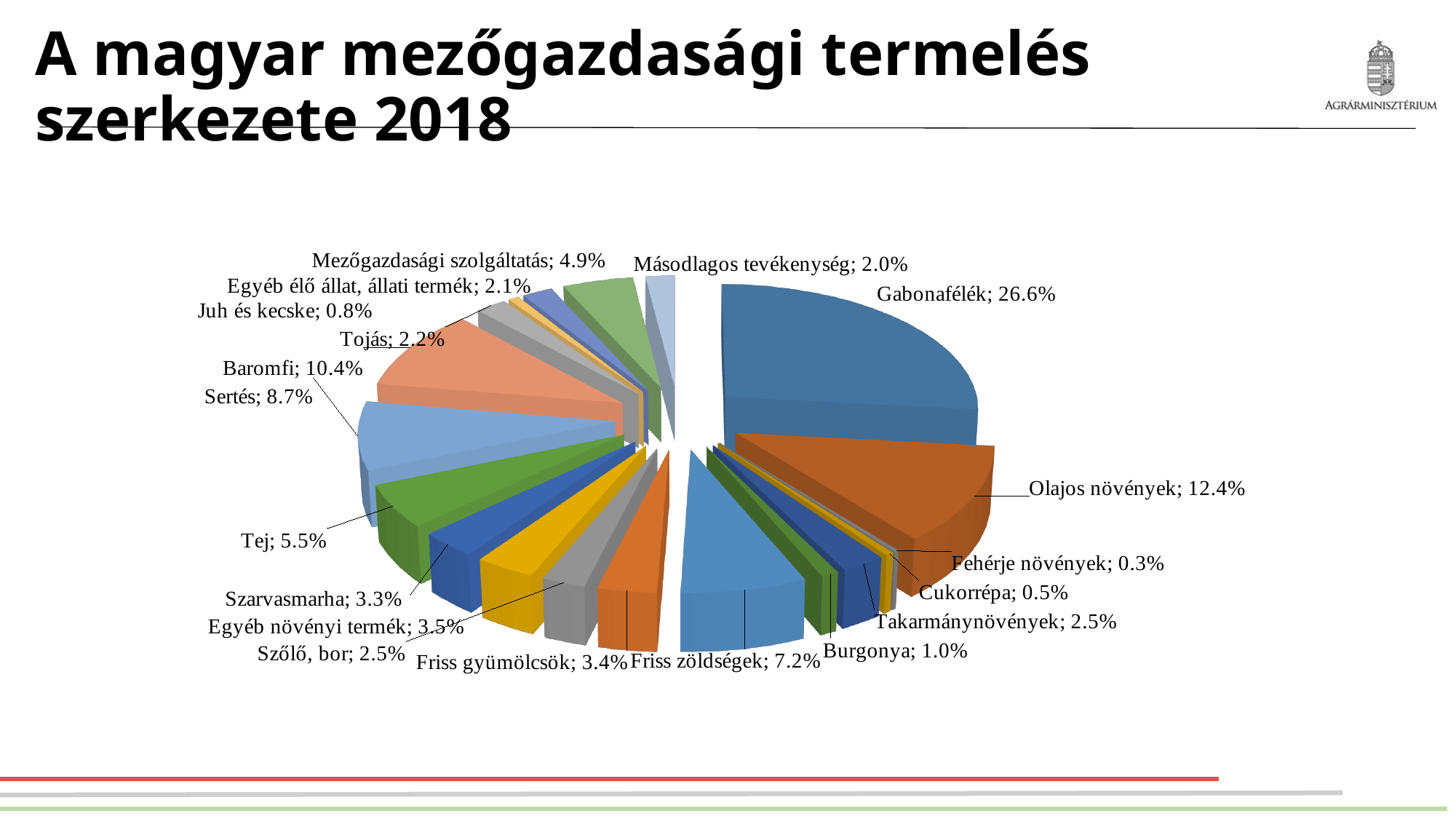
What is the difference between the shares of Gabonafélék and Olajos növények? 14.2% What kind of chart is shown on the slide? pie chart What is the share of Gabonafélék in the pie chart? 26.6% Which category has the smallest share of the pie? Fehérje növények Which is larger, the share of Tej or the share of Szarvasmarha? Tej How many categories are shown in the pie chart? 19 What is the difference between the shares of Baromfi and Sertés? 1.7% What is the value shown for Friss zöldségek? 7.2% What is the share of Olajos növények? 12.4% What is the value shown for Baromfi? 10.4% Which category has the largest share of the pie? Gabonafélék What is the title of the slide containing the chart? A magyar mezőgazdasági termelés szerkezete 2018